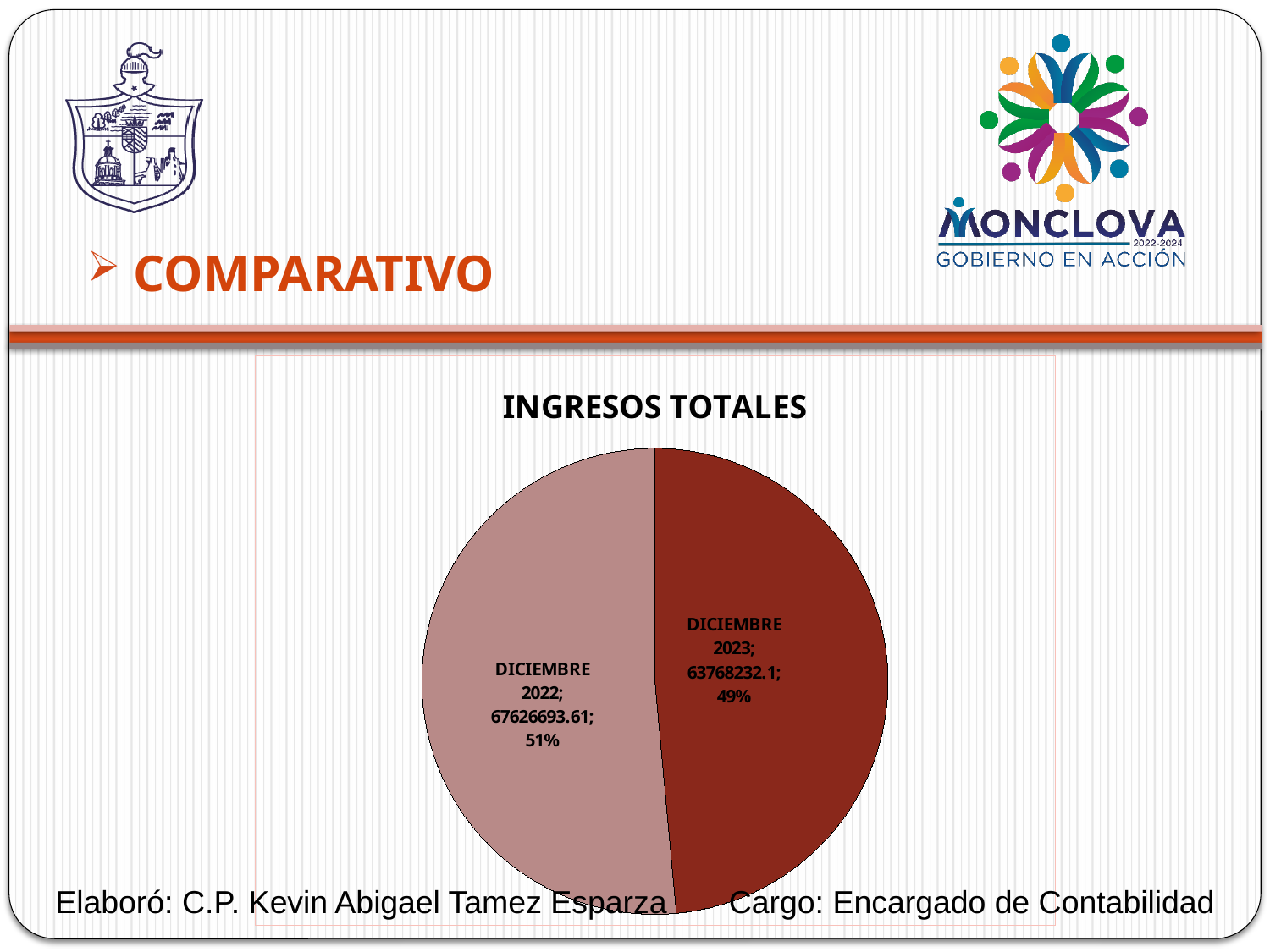
What kind of chart is shown on the slide? pie chart What share of the pie does DICIEMBRE 2023 represent? 49% Which is larger, the value for DICIEMBRE 2022 or DICIEMBRE 2023? DICIEMBRE 2022 How many slices does the pie chart have? 2 Which slice is the largest? DICIEMBRE 2022 What is the value for DICIEMBRE 2023? 63768232.1 Which slice is the smallest? DICIEMBRE 2023 What is the difference between the values for DICIEMBRE 2022 and DICIEMBRE 2023? 3858461.51 What is the title of the chart? INGRESOS TOTALES What share of the pie does DICIEMBRE 2022 represent? 51% What is the value for DICIEMBRE 2022? 67626693.61 What is the total of the two slices in the pie chart? 131394925.71